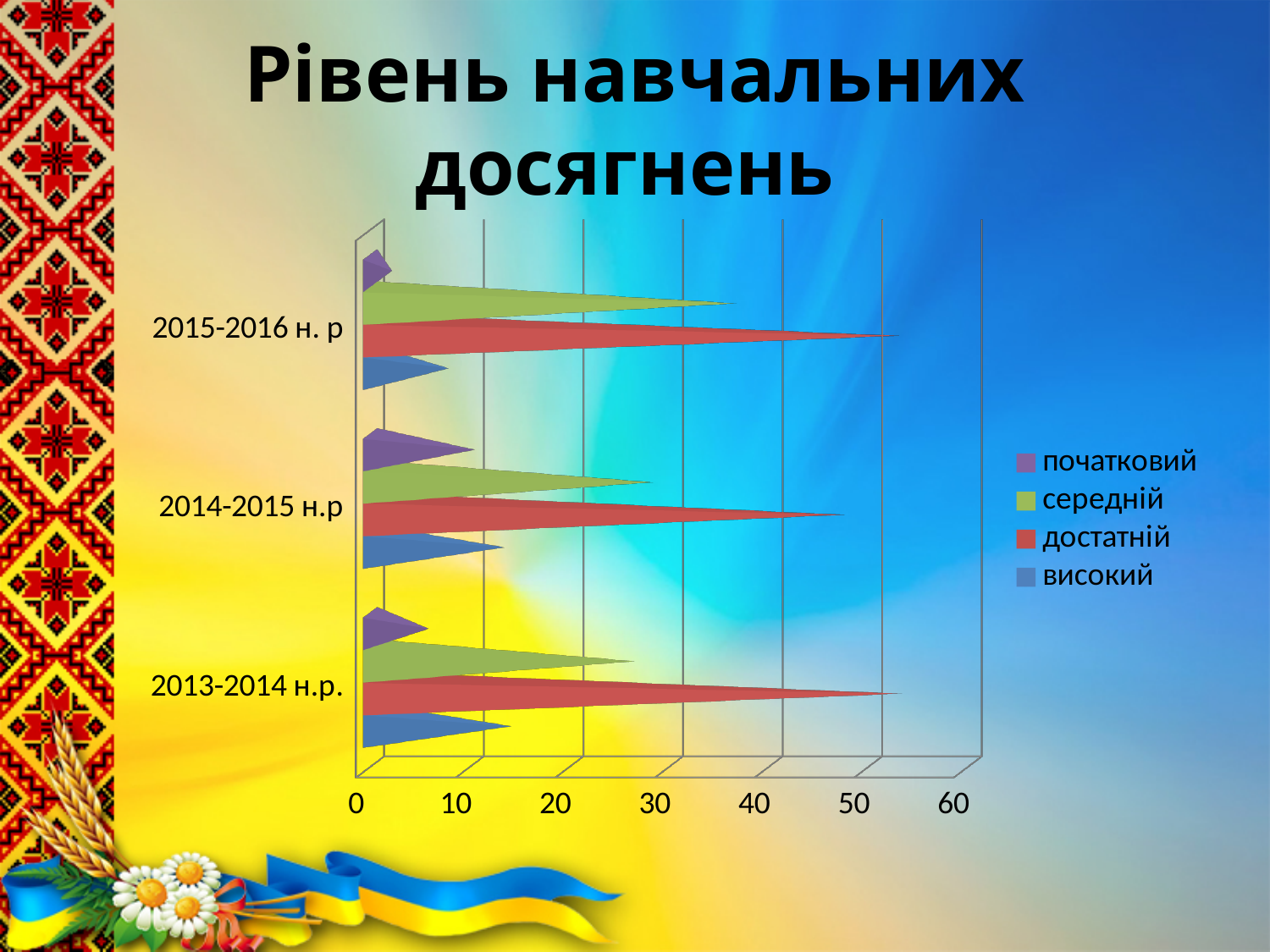
What kind of chart is shown on the slide? bar chart Is the value of достатній for 2014-2015 н.р greater or less than 40? greater How many school-year categories are plotted on the chart? 3 Which series has the highest value for 2015-2016 н. р? достатній Which series has the lowest value for 2015-2016 н. р? початковий What colour represents the достатній series in the legend? red Is the value of високий larger for 2013-2014 н.р. or for 2015-2016 н. р? 2013-2014 н.р. Is the value of середній for 2013-2014 н.р. greater or less than 20? greater Is the value of середній larger for 2015-2016 н. р or for 2014-2015 н.р? 2015-2016 н. р How many series does the legend list? 4 Is the value of високий for 2015-2016 н. р greater or less than 20? less What is the title of the slide? Рівень навчальних досягнень